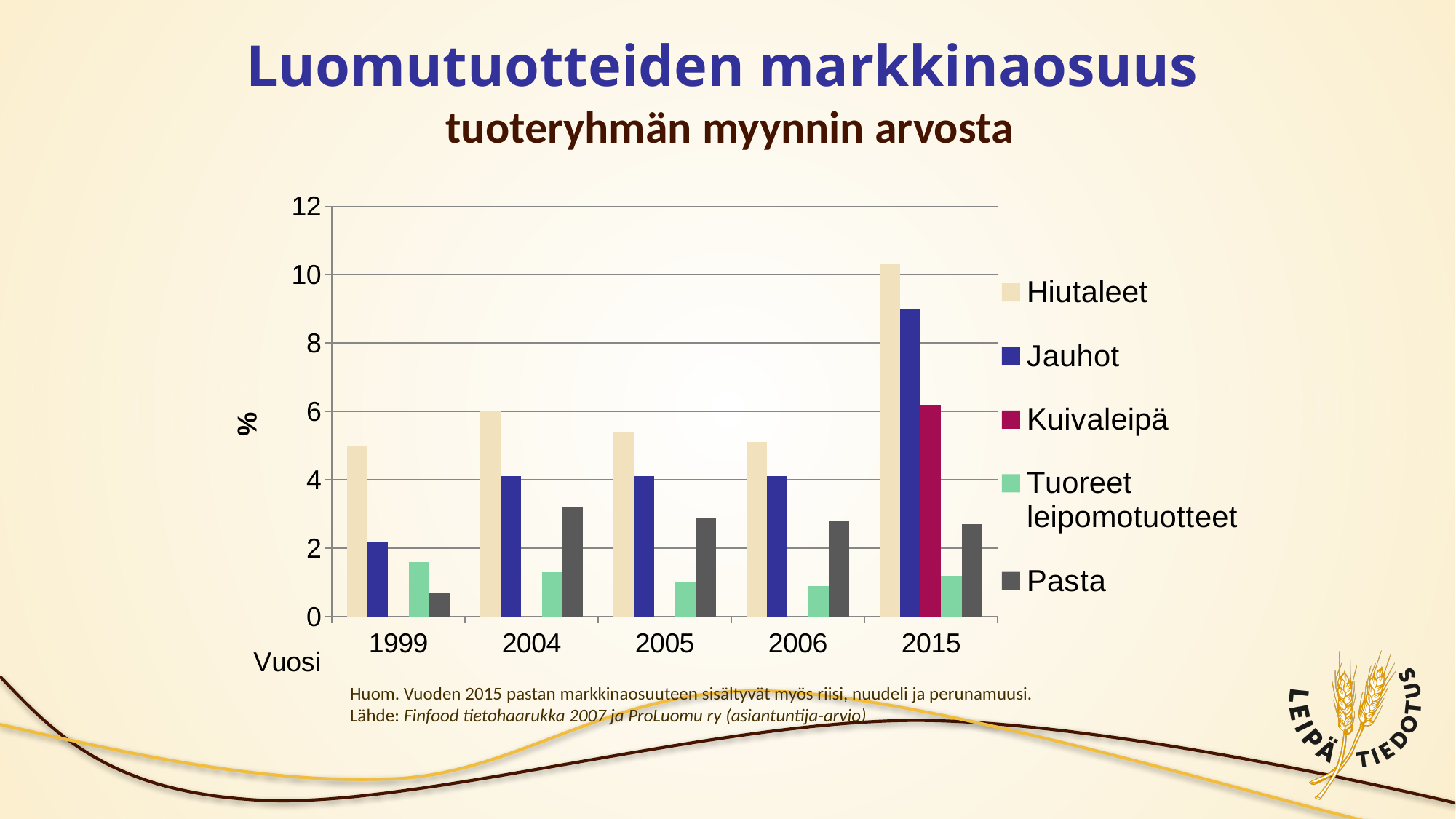
How many series does the legend list? 5 In 2015, which is larger: Hiutaleet or Jauhot? Hiutaleet Which series has a bar only for the year 2015? Kuivaleipä In which year is the value for Pasta lowest? 1999 Does the value for Jauhot rise or fall from 1999 to 2015? rise In 2004, which is larger: Pasta or Tuoreet leipomotuotteet? Pasta Is the value for Jauhot in 2015 greater or less than 8? greater In which year is the value for Hiutaleet highest? 2015 How many years are shown on the x axis? 5 Is the value for Pasta in 2004 greater or less than 4? less What kind of chart is shown on the slide? bar chart Is the value for Hiutaleet in 2015 greater or less than 10? greater